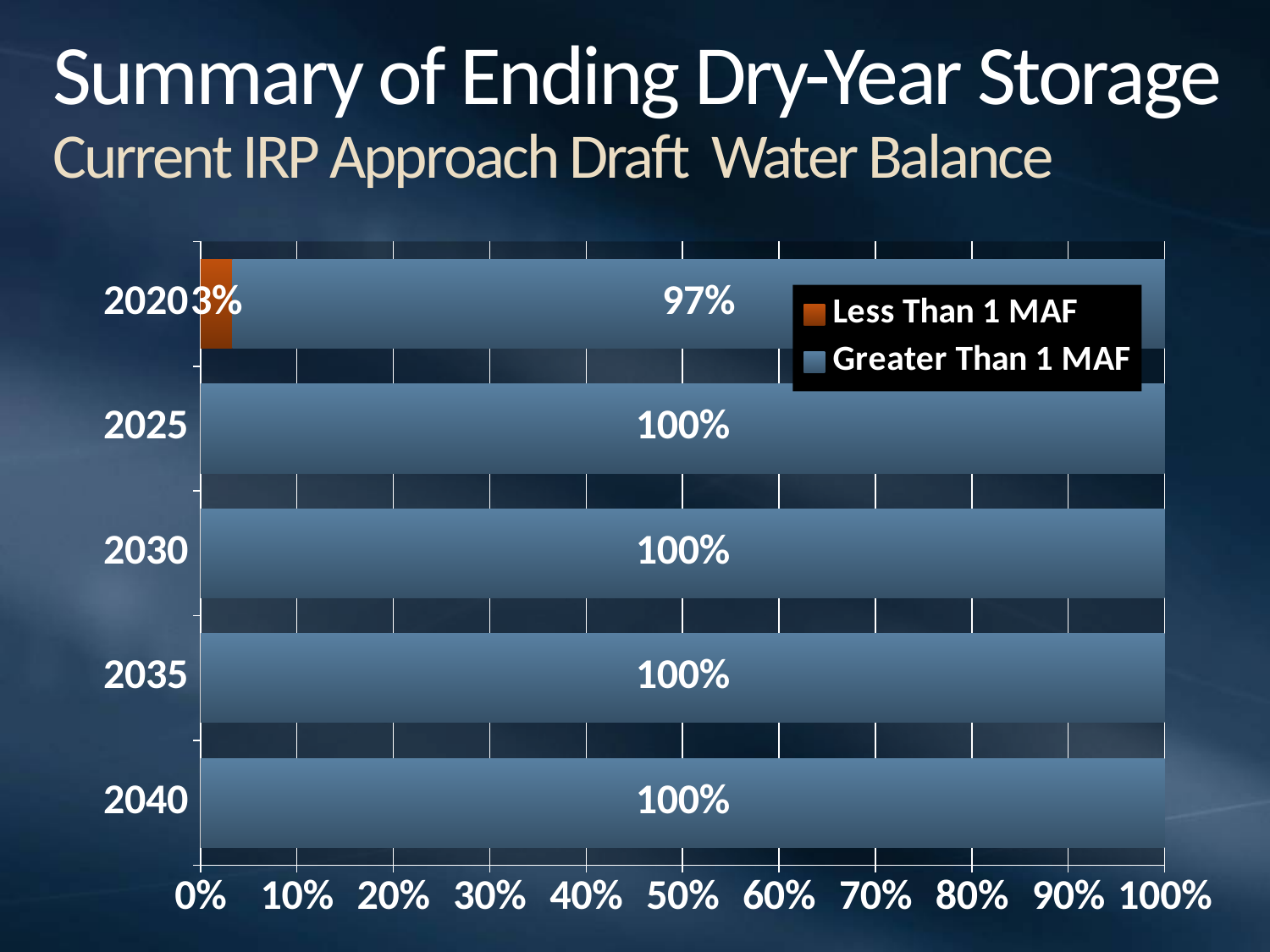
How many year categories are plotted on the chart? 5 What is the total of the stacked bar for 2020? 100% What is the value for Greater Than 1 MAF in 2030? 100% Which series is shown in orange in the legend? Less Than 1 MAF How many series does the legend list? 2 What is the value for Greater Than 1 MAF in 2020? 97% What is the difference between the Greater Than 1 MAF value in 2025 and in 2020? 3% What kind of chart is shown on the slide? bar chart Which year has the lowest value for Greater Than 1 MAF? 2020 What is the value for Greater Than 1 MAF in 2040? 100% What is the value for Less Than 1 MAF in 2020? 3% Which is larger in 2020: the Less Than 1 MAF value or the Greater Than 1 MAF value? Greater Than 1 MAF